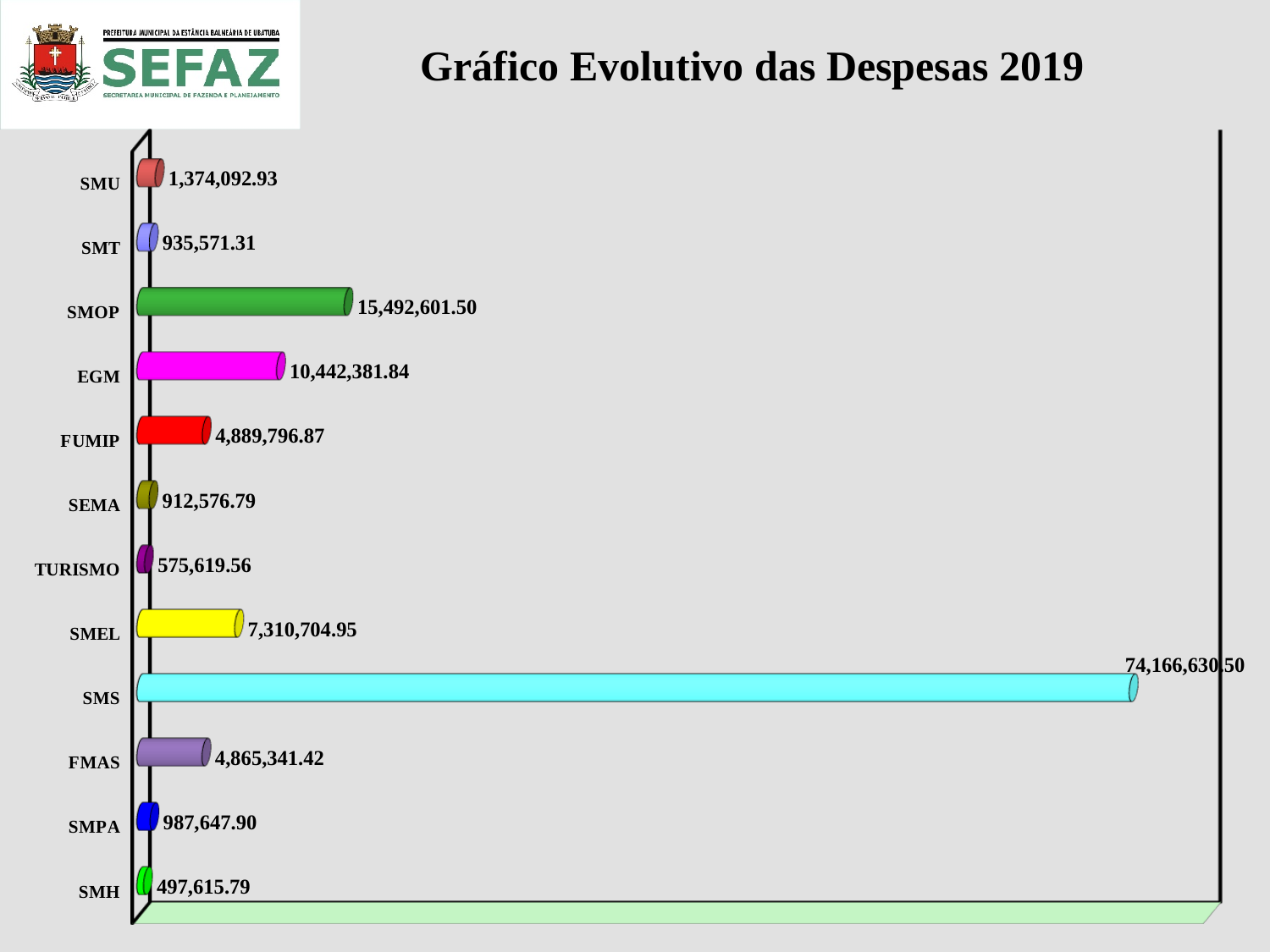
What is the value for FMAS? 4,865,341.42 What is the difference between the values for FUMIP and FMAS? 24,455.45 What is the value for TURISMO? 575,619.56 What kind of chart is shown on the slide? Bar chart Which category has the lowest value? SMH How many categories are shown in the chart? 12 What is the value for SMOP? 15,492,601.50 Which is larger, the value for SMT or the value for SMPA? SMPA Which is larger, the value for SMEL or the value for FUMIP? SMEL Which category has the highest value? SMS What is the value for SMS? 74,166,630.50 What is the difference between the values for SMOP and EGM? 5,050,219.66